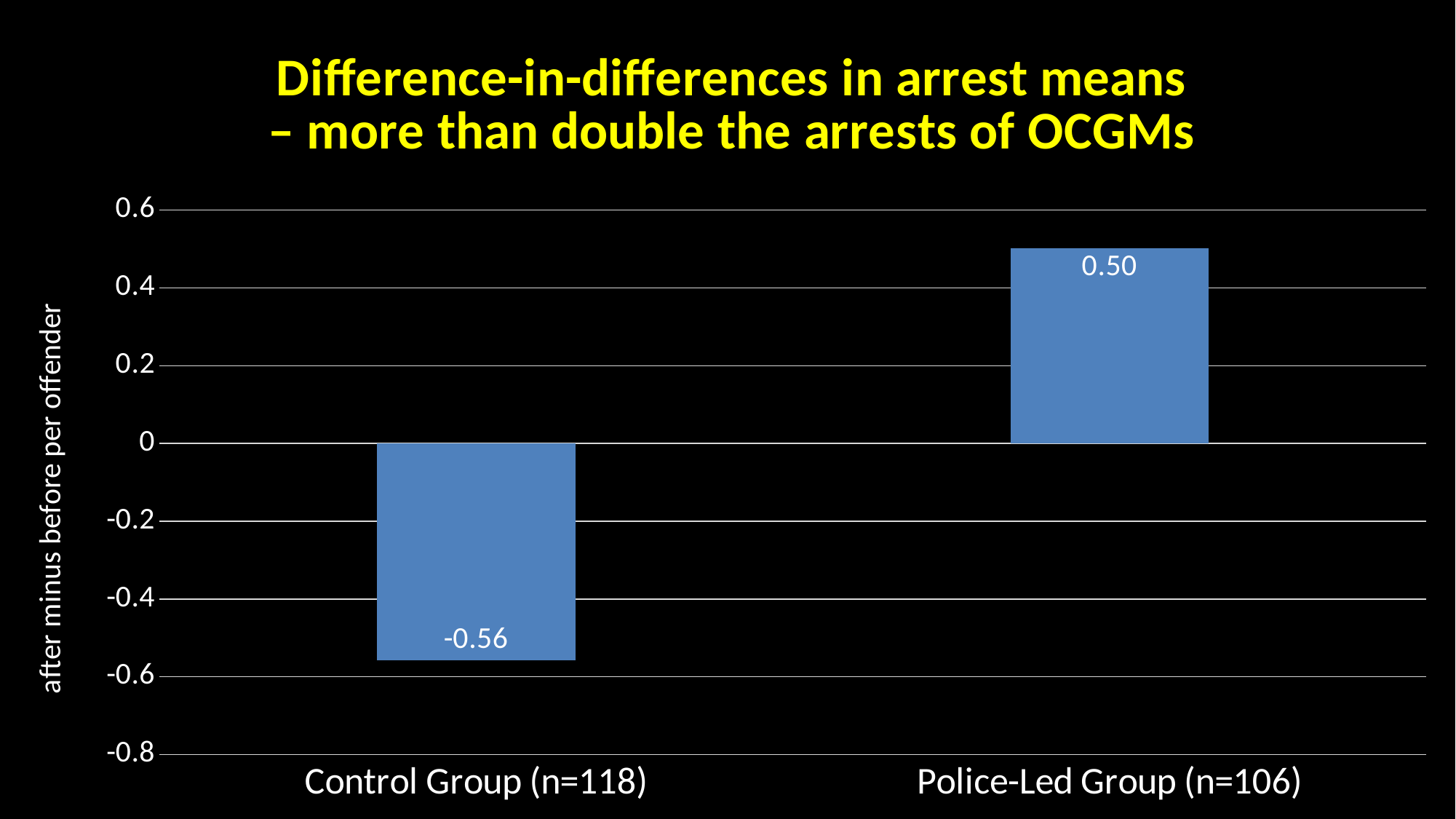
Which group has the higher value? Police-Led Group (n=106) Is the value for the Control Group (n=118) greater or less than -0.4? less What is the value for the Police-Led Group (n=106)? 0.50 What is the value for the Control Group (n=118)? -0.56 Is the value for the Police-Led Group (n=106) greater or less than 0.4? greater How many groups are shown on the chart? 2 Is the value for the Control Group (n=118) larger or smaller than the value for the Police-Led Group (n=106)? smaller What is the title of the chart? Difference-in-differences in arrest means – more than double the arrests of OCGMs What is the label of the vertical axis? after minus before per offender What is the difference between the Police-Led Group value and the Control Group value? 1.06 What kind of chart is shown on the slide? bar chart Which group has the lower value? Control Group (n=118)